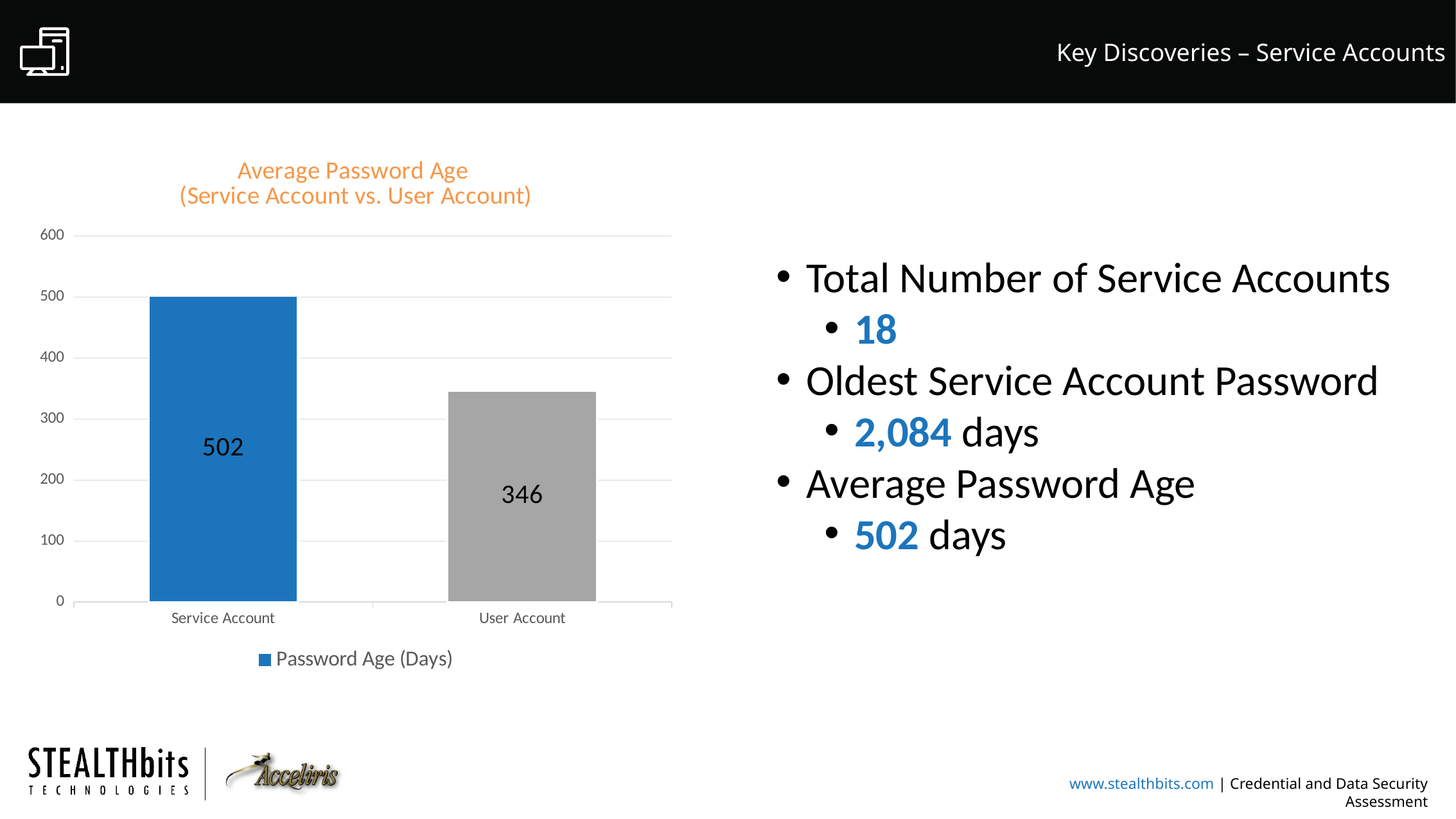
What is the password age value for Service Account? 502 What is the legend entry of the chart? Password Age (Days) What is the password age value for User Account? 346 What is the difference between the Service Account and User Account password age values? 156 Is the value for Service Account greater or less than 500? greater Which category has the highest password age? Service Account Is the value for User Account greater or less than 400? less What kind of chart is shown on the slide? bar chart Which is larger, the value for Service Account or the value for User Account? Service Account Which category has the lowest password age? User Account How many categories are shown on the x axis? 2 How many series does the legend list? 1